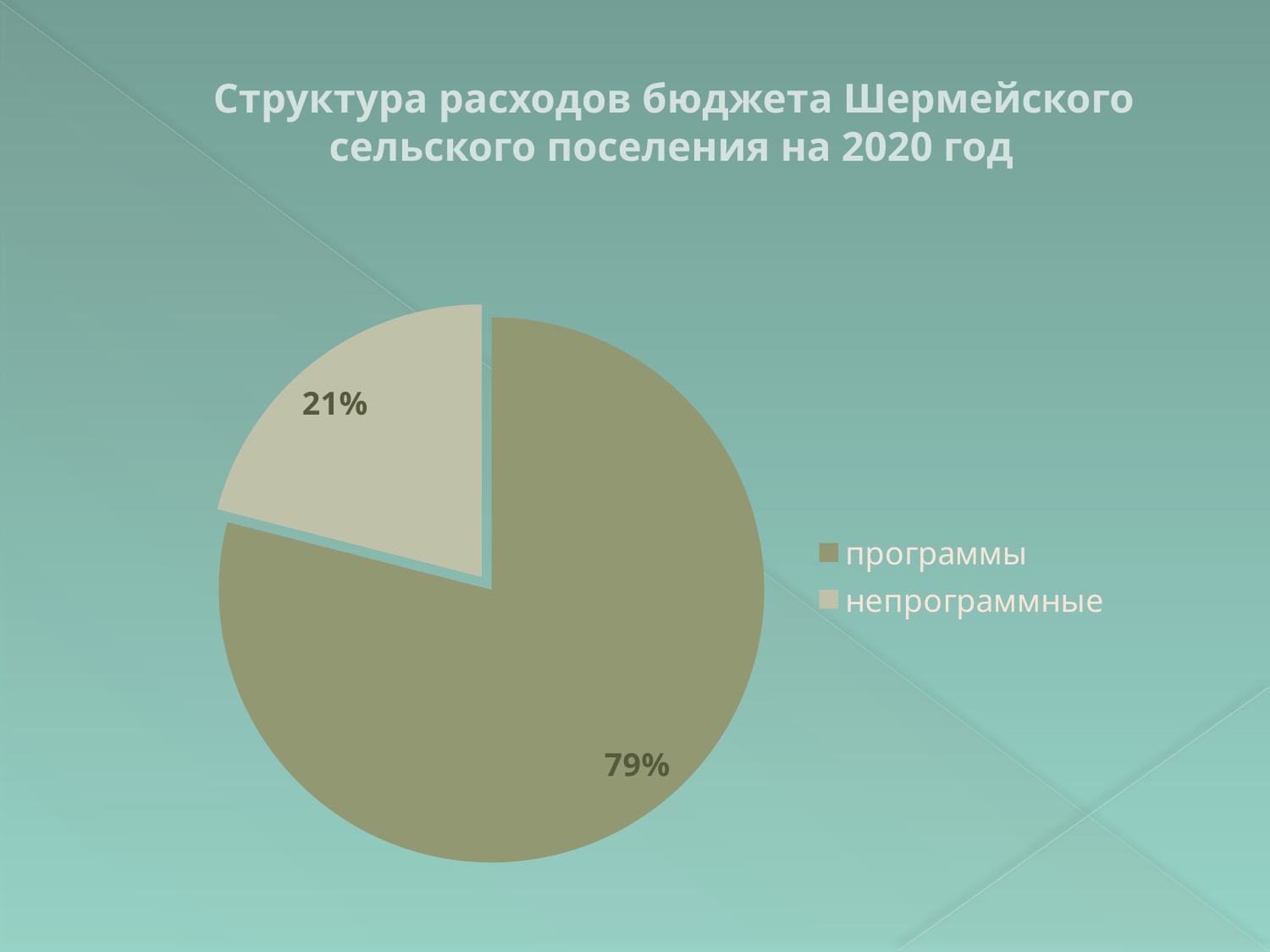
What is the title of the chart? Структура расходов бюджета Шермейского сельского поселения на 2020 год Which category has the smallest slice of the pie? непрограммные What share of the pie does the "программы" slice represent? 79% Which is larger: the "программы" slice or the "непрограммные" slice? программы Which category has the largest slice of the pie? программы How many categories are shown in the pie chart? 2 Which legend entry is shown with the lighter colour? непрограммные How many entries does the legend list? 2 What is the difference in percentage points between the "программы" and "непрограммные" slices? 58 What kind of chart is shown on the slide? pie chart What share of the pie does the "непрограммные" slice represent? 21%